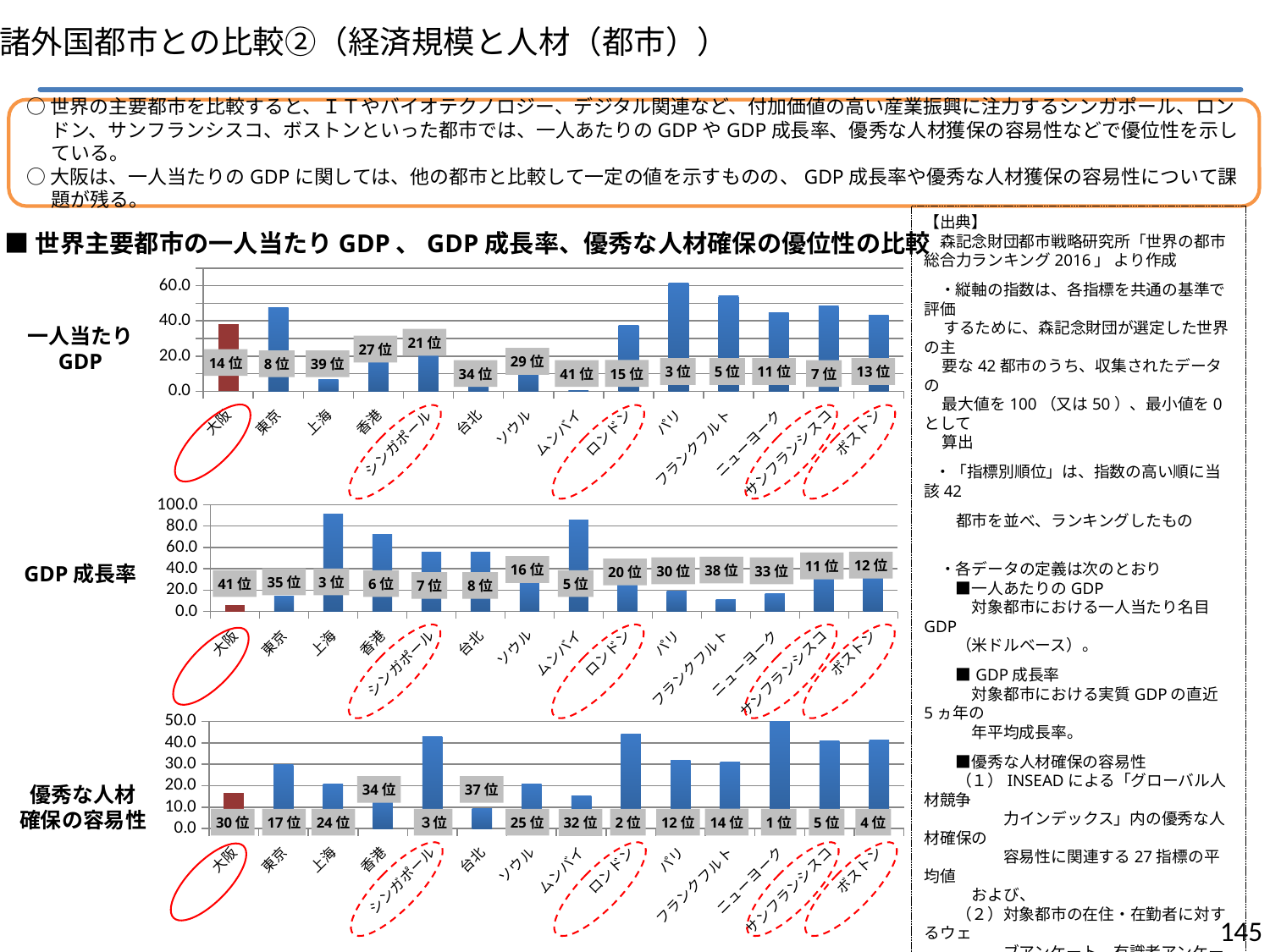
What type of chart is the GDP成長率 chart (middle)? bar chart In the GDP成長率 chart (middle), which city has the shortest bar? 大阪 In the GDP成長率 chart (middle), what rank label is shown for 大阪? 41位 In the 一人当たりGDP chart (top), what rank label is shown for 大阪? 14位 In the 優秀な人材確保の容易性 chart (bottom), which city has the shortest bar? 台北 In the 優秀な人材確保の容易性 chart (bottom), what rank label is shown for ニューヨーク? 1位 In the 優秀な人材確保の容易性 chart (bottom), which bar is taller, シンガポール or 東京? シンガポール How many cities are shown on the x axis of the 一人当たりGDP chart (top)? 14 In the 一人当たりGDP chart (top), is the value for 大阪 greater or less than 20.0? greater In the 一人当たりGDP chart (top), which city has the tallest bar? パリ In the GDP成長率 chart (middle), which city has the tallest bar? 上海 In the GDP成長率 chart (middle), is the value for 上海 greater or less than 80.0? greater